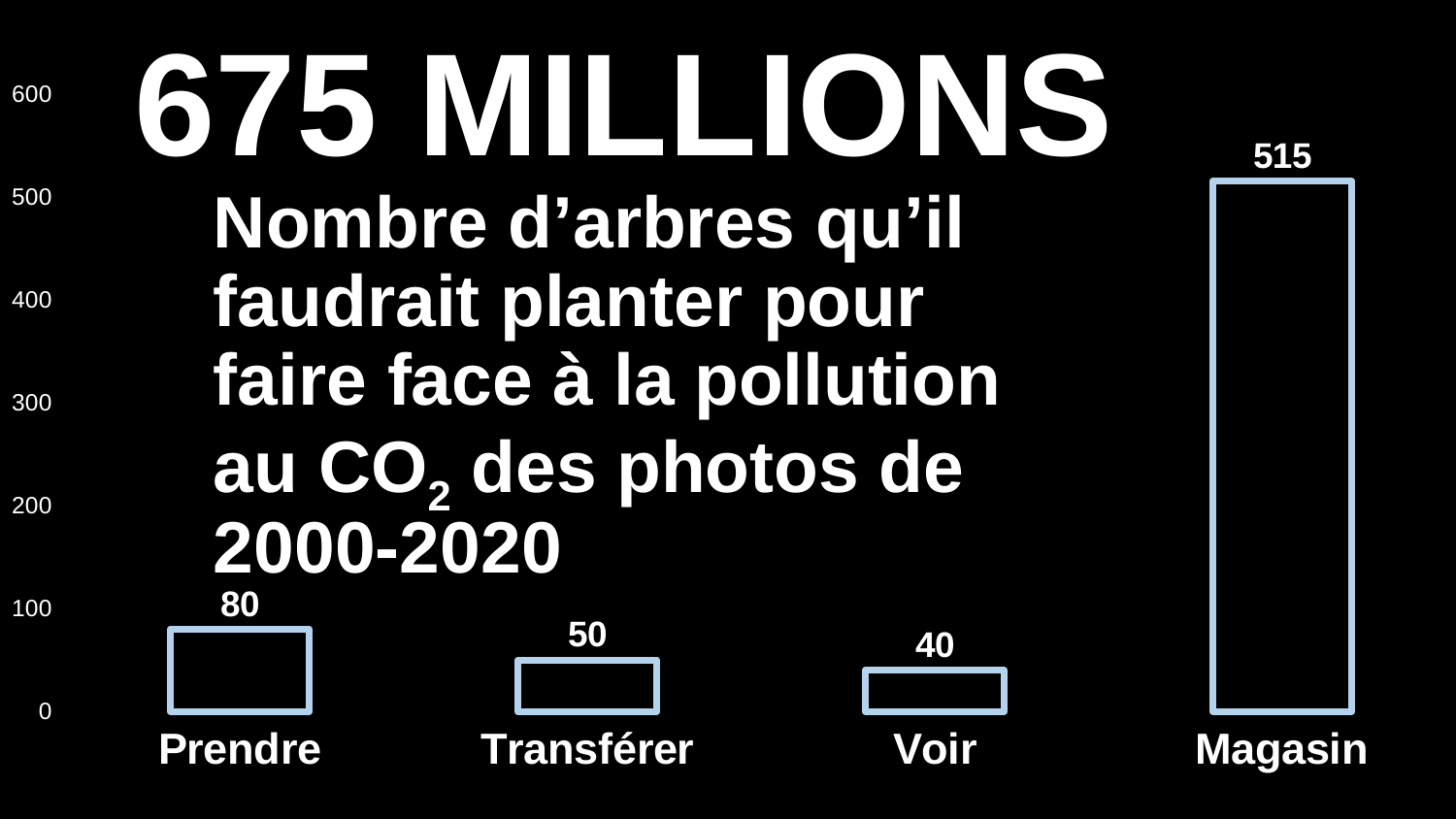
Which category has the lowest value? Voir What is the value for Magasin? 515 What is the difference between the values for Transférer and Voir? 10 What is the value for Prendre? 80 Which is larger, the value for Prendre or the value for Transférer? Prendre What is the difference between the values for Magasin and Prendre? 435 What is the value for Transférer? 50 Which category has the highest value? Magasin What is the value for Voir? 40 What kind of chart is shown on the slide? bar chart Is the value for Magasin greater or less than 500? greater How many categories are shown on the x axis? 4